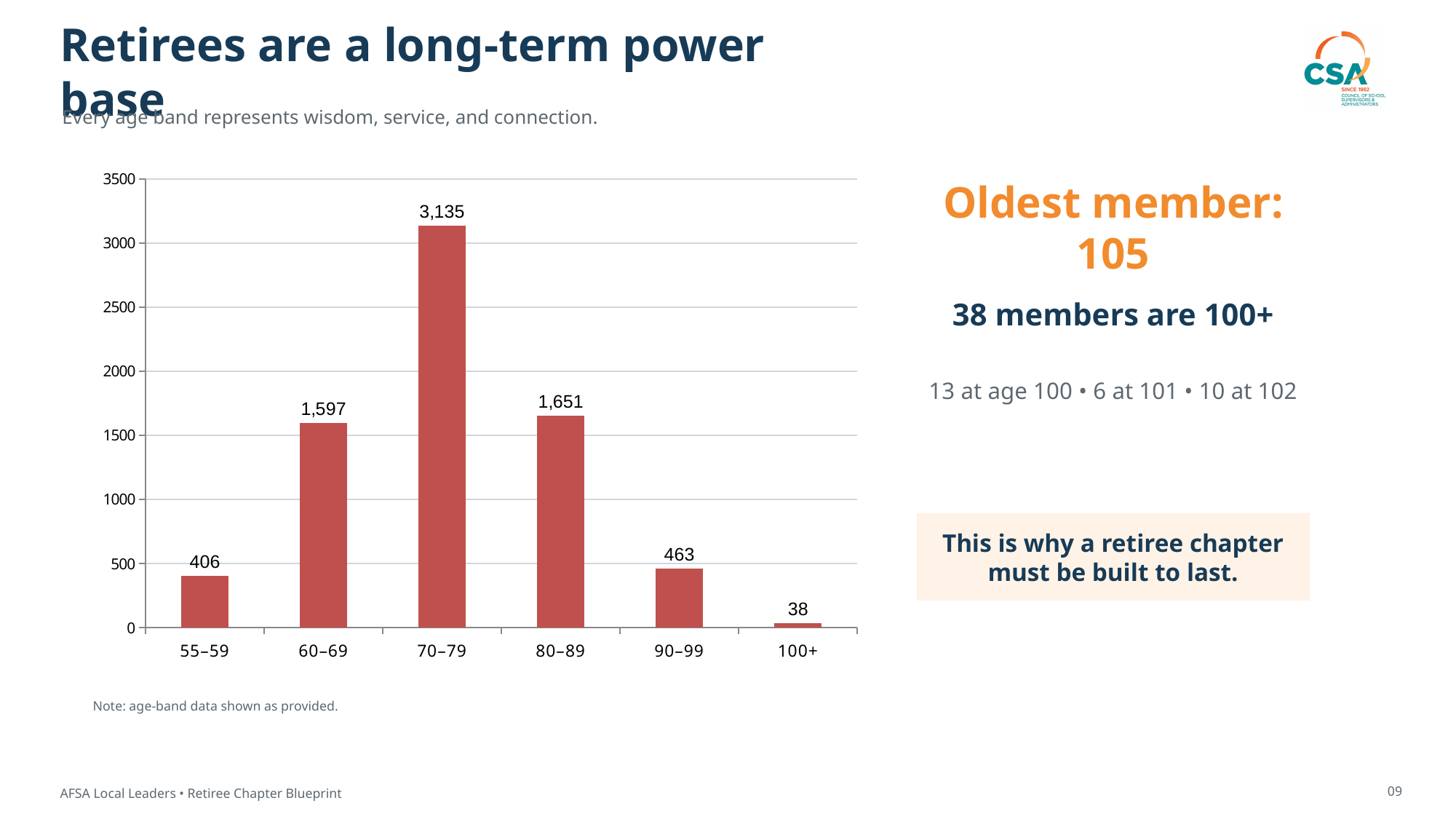
What is the difference between the values for 80–89 and 60–69? 54 What is the value for the 55–59 age band? 406 What is the total of the values for the 90–99 and 100+ age bands? 501 How many age bands are shown on the x axis? 6 Which age band has the lowest value? 100+ What is the difference between the values for 70–79 and 80–89? 1,484 Which age band has the highest value? 70–79 What is the value for the 100+ age band? 38 Is the value for 60–69 greater or less than 1500? greater What is the value for the 70–79 age band? 3,135 Which is larger, the value for 90–99 or the value for 55–59? 90–99 What kind of chart is shown on the slide? Bar chart